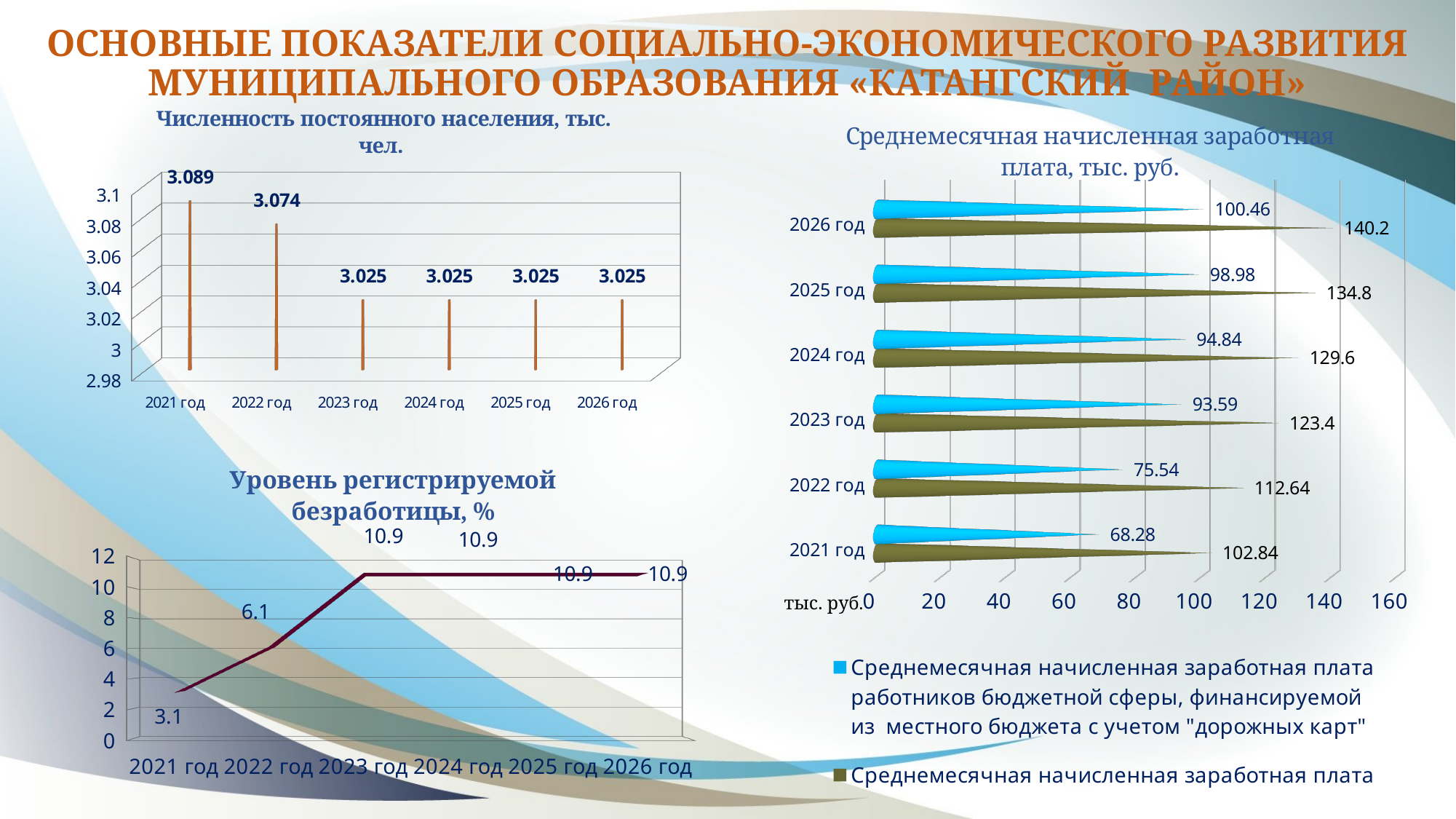
In the chart 'Среднемесячная начисленная заработная плата, тыс. руб.', what is the value of 'Среднемесячная начисленная заработная плата' for 2026 год? 140.2 In the chart 'Среднемесячная начисленная заработная плата, тыс. руб.', which is larger for 2023 год: the blue series value or the olive series value? the olive series (123.4) In the chart 'Численность постоянного населения, тыс. чел.', how many years are shown on the x axis? 6 In the chart 'Уровень регистрируемой безработицы, %', what is the value for 2022 год? 6.1 In the chart 'Численность постоянного населения, тыс. чел.', which year has the highest value? 2021 год In the chart 'Среднемесячная начисленная заработная плата, тыс. руб.', what is the value for 2021 год of the series for workers of the budget sphere financed from the local budget (the blue series)? 68.28 In the chart 'Уровень регистрируемой безработицы, %', do the values rise or fall from 2021 год to 2023 год? rise In the chart 'Численность постоянного населения, тыс. чел.', what is the value for 2021 год? 3.089 In the chart 'Уровень регистрируемой безработицы, %', what is the difference between the values for 2023 год and 2021 год? 7.8 What kind of chart is 'Уровень регистрируемой безработицы, %'? line chart In the chart 'Среднемесячная начисленная заработная плата, тыс. руб.', how many series does the legend list? 2 In the chart 'Численность постоянного населения, тыс. чел.', what is the difference between the values for 2021 год and 2022 год? 0.015